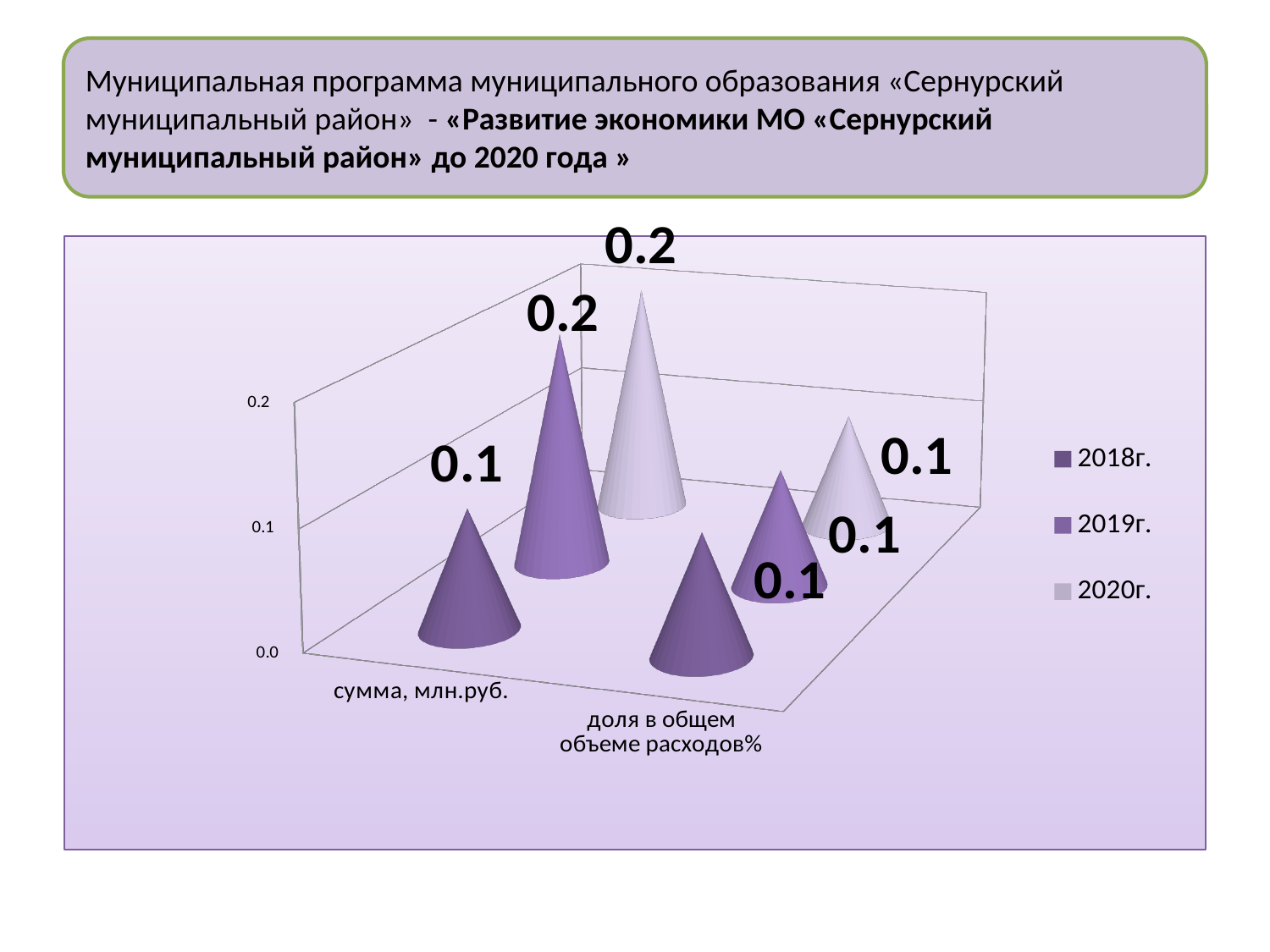
What is the value for 2018г. in the «сумма, млн.руб.» category? 0.1 What are the legend entries of the chart? 2018г., 2019г., 2020г. What kind of chart is shown on the slide? bar chart What is the difference between the 2019г. and 2018г. values in the «сумма, млн.руб.» category? 0.1 In the «сумма, млн.руб.» category, which is larger: the value for 2018г. or for 2019г.? 2019г. How many series does the legend list? 3 Which series has the lowest value in the «сумма, млн.руб.» category? 2018г. What is the value for 2019г. in the «сумма, млн.руб.» category? 0.2 What is the value for 2020г. in the «сумма, млн.руб.» category? 0.2 What is the value for 2020г. in the «доля в общем объеме расходов%» category? 0.1 How many categories are shown on the chart's category axis? 2 What is the value for 2018г. in the «доля в общем объеме расходов%» category? 0.1